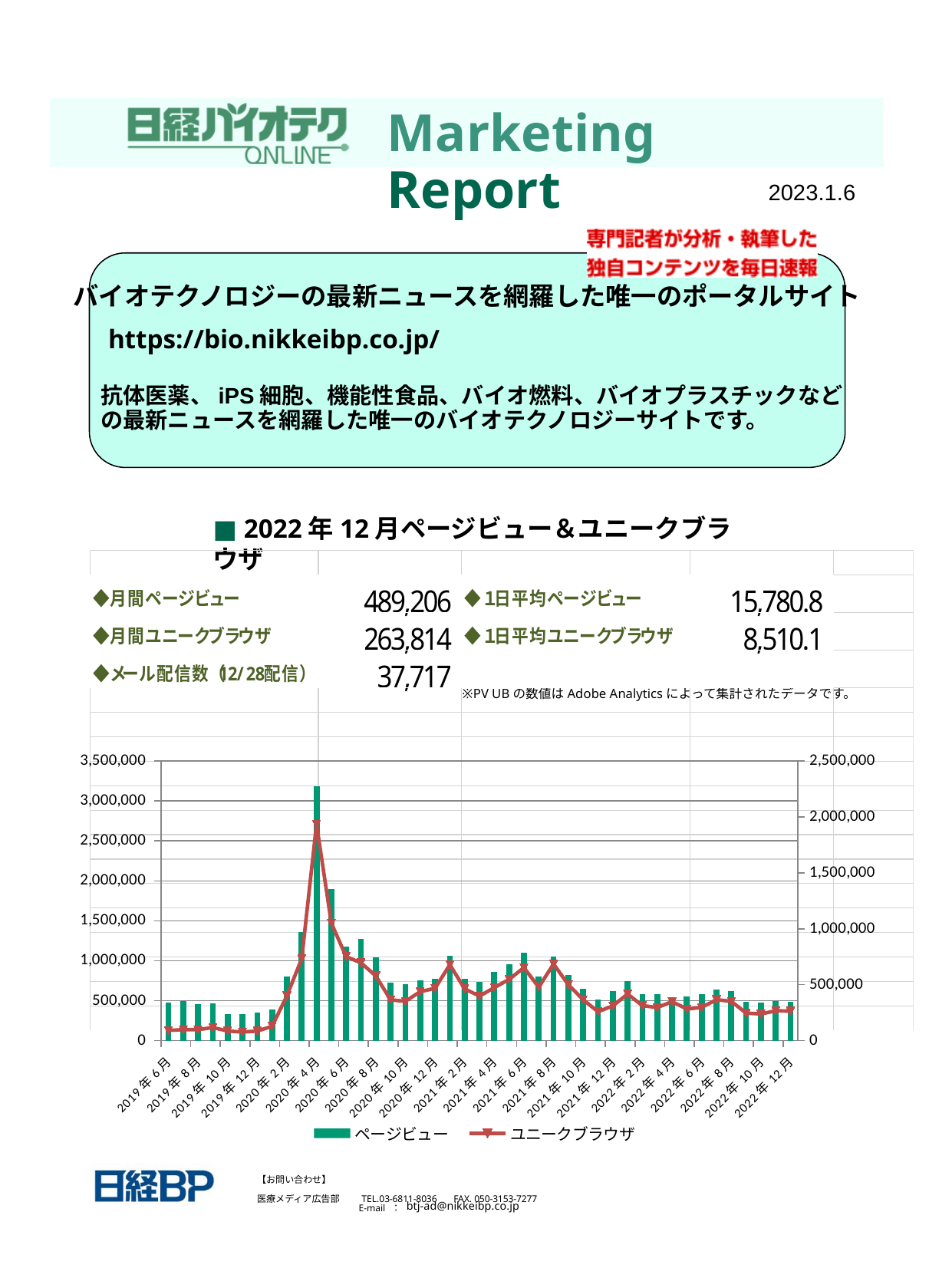
According to the figures printed above the chart, what is the monthly page view count (月間ページビュー) for December 2022? 489,206 What are the two series named in the chart legend? ページビュー and ユニークブラウザ How many series does the chart legend list? 2 Which month has the highest page views (ページビュー) bar in the chart? 2020年4月 Is the unique browsers (ユニークブラウザ) value for 2020年4月 greater or less than 1,500,000 on the right axis? greater Which month has the larger page views (ページビュー) bar, 2020年4月 or 2021年8月? 2020年4月 What is the maximum value shown on the left vertical axis of the chart? 3,500,000 Do page views (ページビュー) rise or fall from 2020年4月 to 2020年10月? fall What kind of chart is shown on the slide? A combination bar and line chart According to the figures printed above the chart, what is the monthly unique browser count (月間ユニークブラウザ) for December 2022? 263,814 Is the page views (ページビュー) value for 2019年6月 greater or less than 1,000,000? less Is the page views (ページビュー) value for 2020年4月 greater or less than 3,000,000? greater